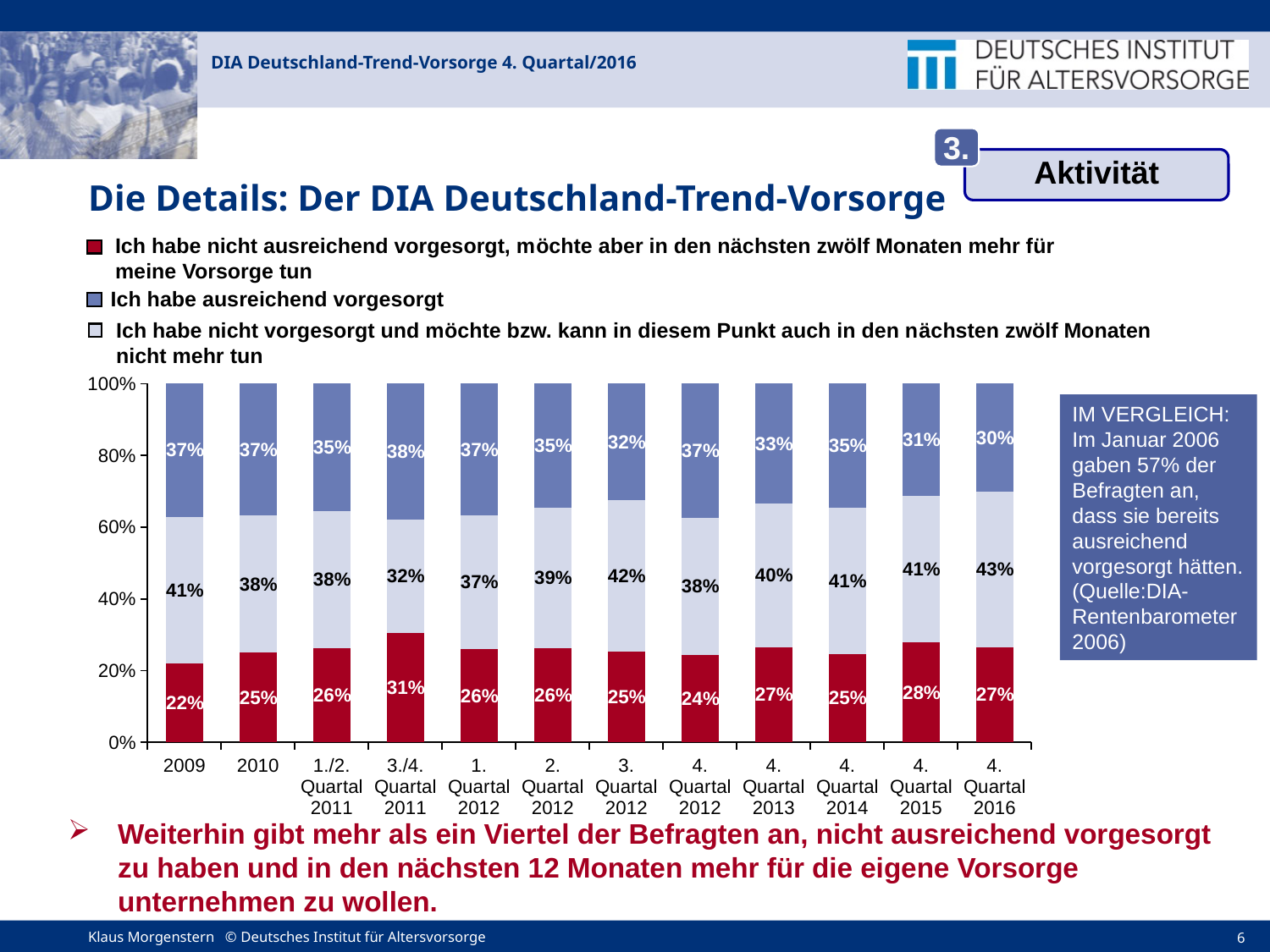
Which has the larger bottom (red) segment value, 2009 or 2010? 2010 In which period is the top segment the lowest? 4. Quartal 2016 What is the difference between the middle segment values for 4. Quartal 2016 and 3./4. Quartal 2011? 11 percentage points What is the total of the stacked bar for 2009? 100% In which period is the bottom (red) segment the highest? 3./4. Quartal 2011 What kind of chart is shown on the slide? Stacked bar chart What is the value of the top segment for 3. Quartal 2012? 32% How many categories (time periods) are shown on the x axis of the chart? 12 What is the value of the bottom (red) segment for 3./4. Quartal 2011? 31% How many series does the legend list? 3